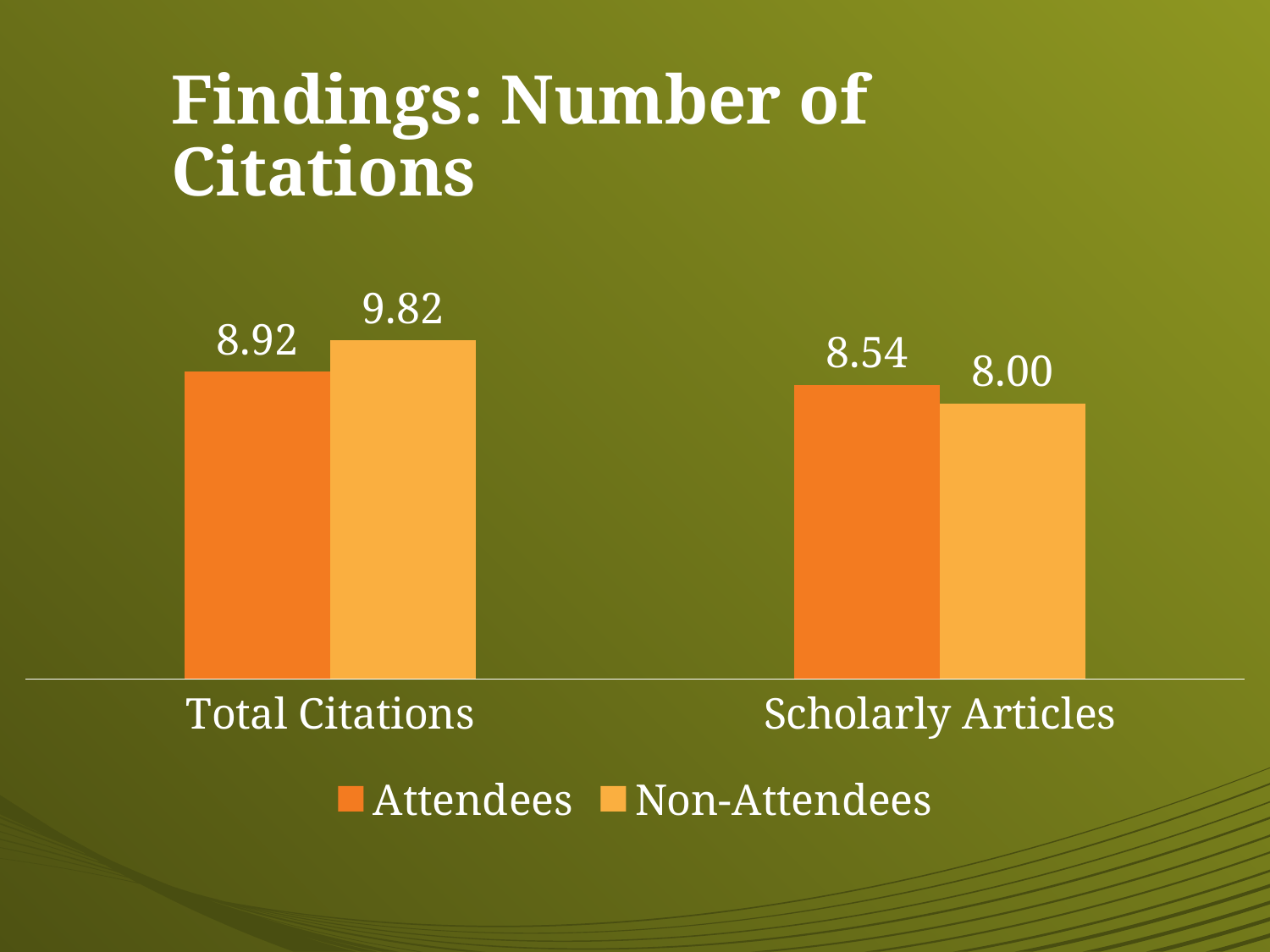
Which bar has the lowest value on the chart? Non-Attendees, Scholarly Articles What is the value for Non-Attendees in the Total Citations category? 9.82 What is the value for Attendees in the Scholarly Articles category? 8.54 What is the value for Attendees in the Total Citations category? 8.92 How many series does the legend list? 2 How many categories are shown on the x axis? 2 What kind of chart is shown on the slide? Bar chart What is the difference between Non-Attendees and Attendees in the Total Citations category? 0.90 In the Scholarly Articles category, which is larger: Attendees or Non-Attendees? Attendees What is the difference between Attendees and Non-Attendees in the Scholarly Articles category? 0.54 What is the value for Non-Attendees in the Scholarly Articles category? 8.00 Which bar has the highest value on the chart? Non-Attendees, Total Citations